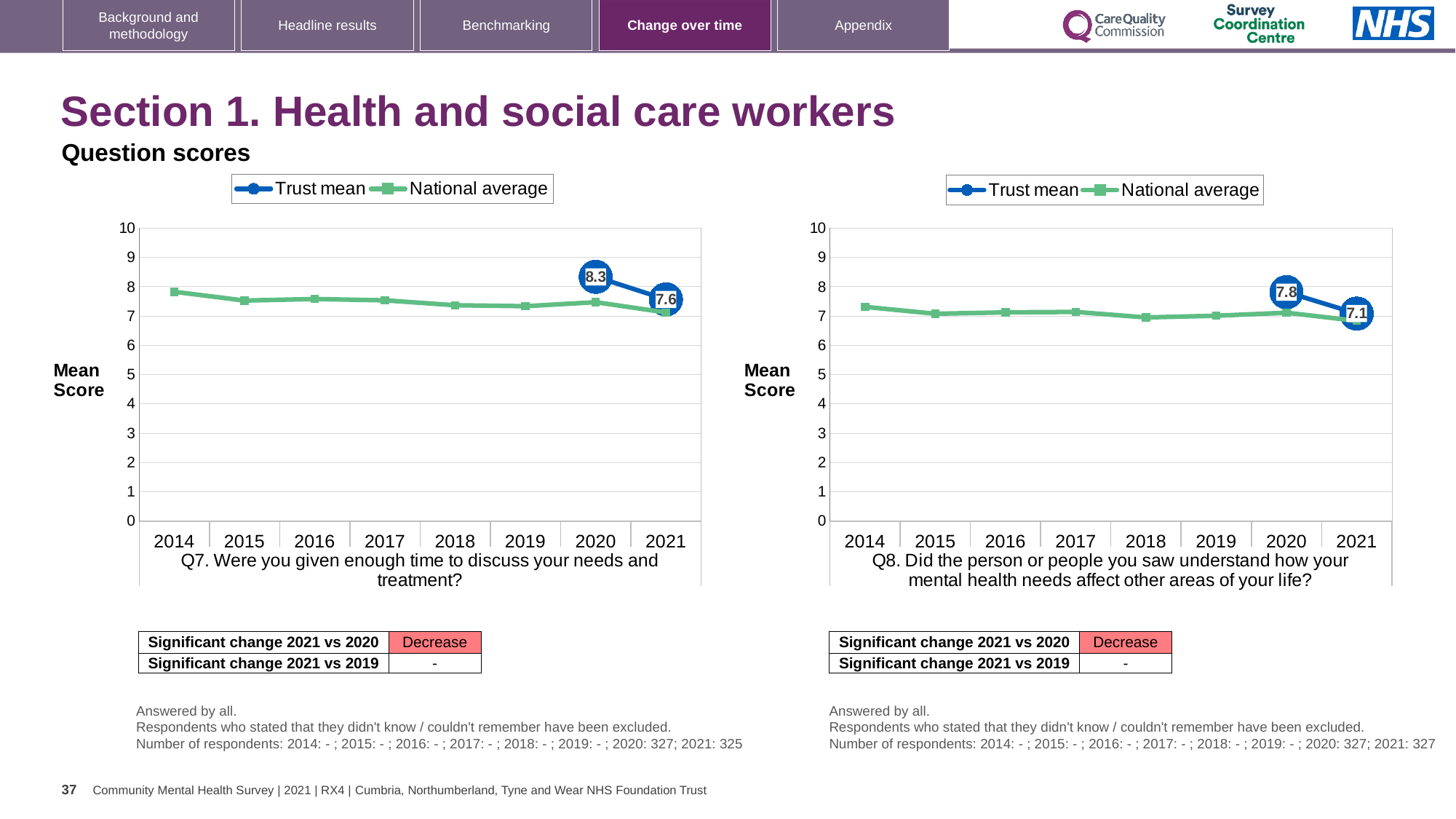
In the Q8 chart (right), what is the Trust mean for 2020? 7.8 What kind of chart is the Q7 chart (left)? Line chart In the Q8 chart (right), what is the Trust mean for 2021? 7.1 Which is larger: the 2021 Trust mean in the Q7 chart (left) or the 2021 Trust mean in the Q8 chart (right)? Q7 chart (left) In the Q7 chart (left), what is the Trust mean for 2021? 7.6 In the Q8 chart (right), what is the difference between the Trust mean in 2020 and in 2021? 0.7 In the Q8 chart (right), is the National average for 2018 greater or less than 8? less How many series does the legend of the Q8 chart (right) list? 2 In the Q7 chart (left), what is the Trust mean for 2020? 8.3 In the Q8 chart (right), does the Trust mean rise or fall from 2020 to 2021? Fall In the Q7 chart (left), by how much did the Trust mean fall from 2020 to 2021? 0.7 How many years are shown on the x axis of the Q7 chart (left)? 8